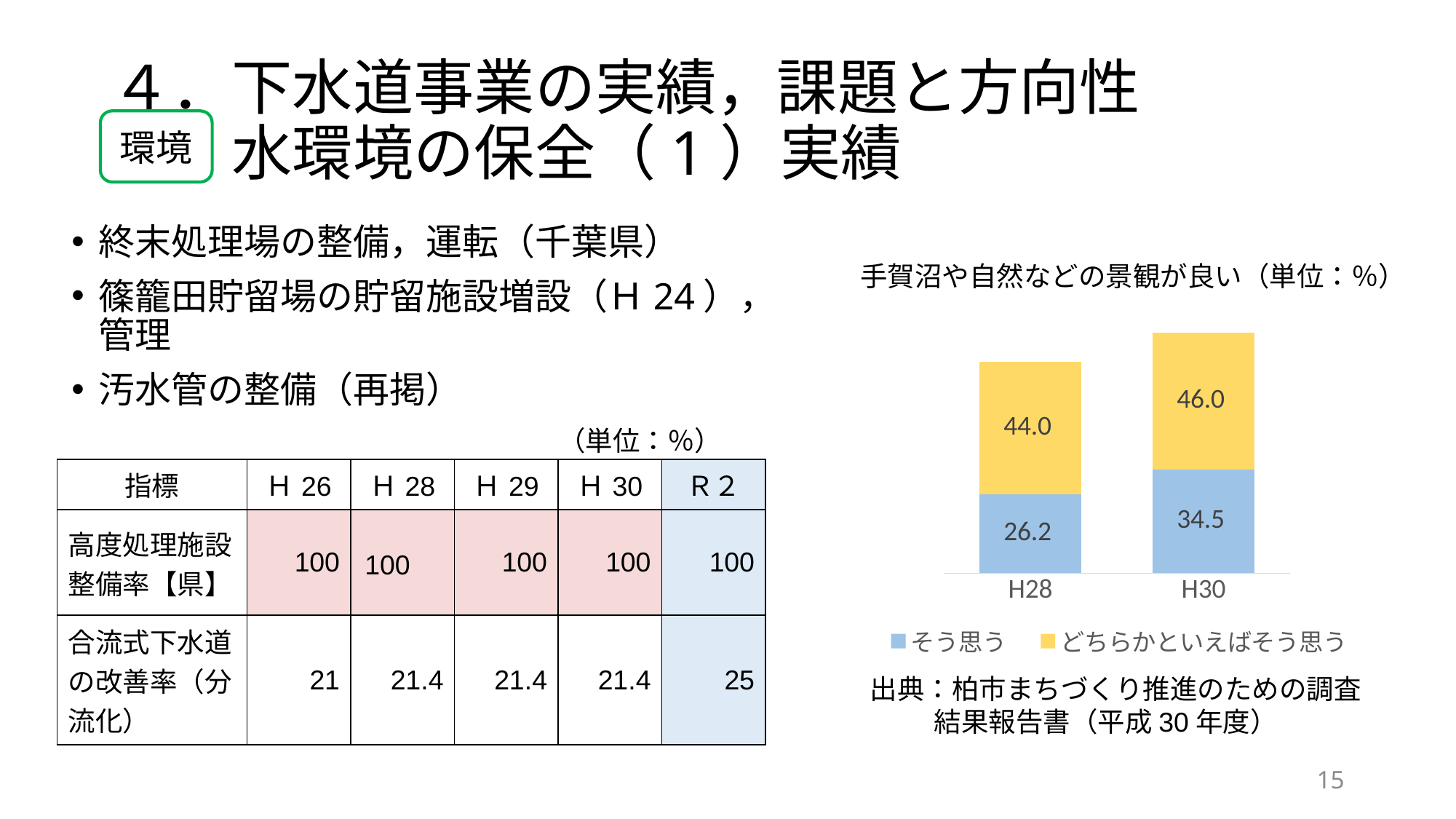
グラフ「手賀沼や自然などの景観が良い」で、H30の「そう思う」の値はいくつですか？ 34.5 グラフ「手賀沼や自然などの景観が良い」で、「そう思う」はどの色で表されていますか？ 青 グラフ「手賀沼や自然などの景観が良い」で、H30の「どちらかといえばそう思う」の値はいくつですか？ 46.0 グラフ「手賀沼や自然などの景観が良い」で、H30の積み上げ棒の合計はいくつですか？ 80.5 グラフ「手賀沼や自然などの景観が良い」で、「そう思う」のH30とH28の差はいくつですか？ 8.3 グラフ「手賀沼や自然などの景観が良い」はどの種類のグラフですか？ 積み上げ棒グラフ グラフ「手賀沼や自然などの景観が良い」で、H28の「どちらかといえばそう思う」の値はいくつですか？ 44.0 グラフ「手賀沼や自然などの景観が良い」で、H28の「そう思う」の値はいくつですか？ 26.2 グラフ「手賀沼や自然などの景観が良い」で、「そう思う」の値はH28とH30のどちらが大きいですか？ H30 グラフ「手賀沼や自然などの景観が良い」の凡例にはいくつの系列がありますか？ 2 グラフ「手賀沼や自然などの景観が良い」には、いくつのカテゴリ（年度）がありますか？ 2 グラフ「手賀沼や自然などの景観が良い」で、H28の積み上げ棒の合計はいくつですか？ 70.2